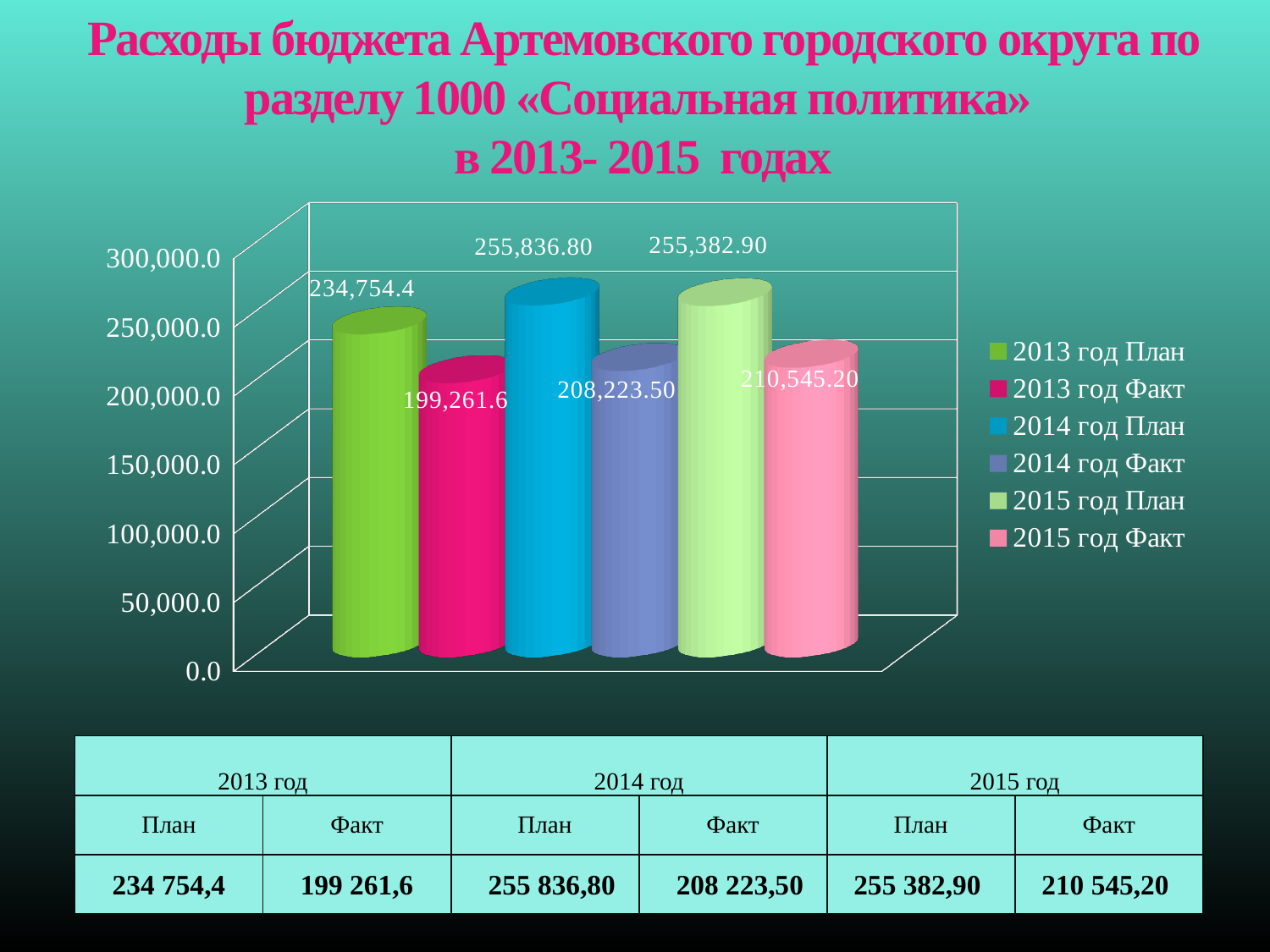
How many series does the legend list? 6 What is the difference between the 2014 год План and 2014 год Факт values? 47,613.30 What kind of chart is shown on the slide? bar chart Which series has the lowest value in the chart? 2013 год Факт What colour is the 2013 год Факт bar? pink (magenta) What is the difference between the 2013 год План and 2013 год Факт values? 35,492.8 Which series has the highest value in the chart? 2014 год План What is the value of the 2014 год Факт bar? 208,223.50 What is the value of the 2013 год План bar? 234,754.4 Which is larger, the 2015 год План value or the 2015 год Факт value? 2015 год План Is the value for 2014 год План greater or less than 250,000.0? greater What is the value of the 2015 год Факт bar? 210,545.20